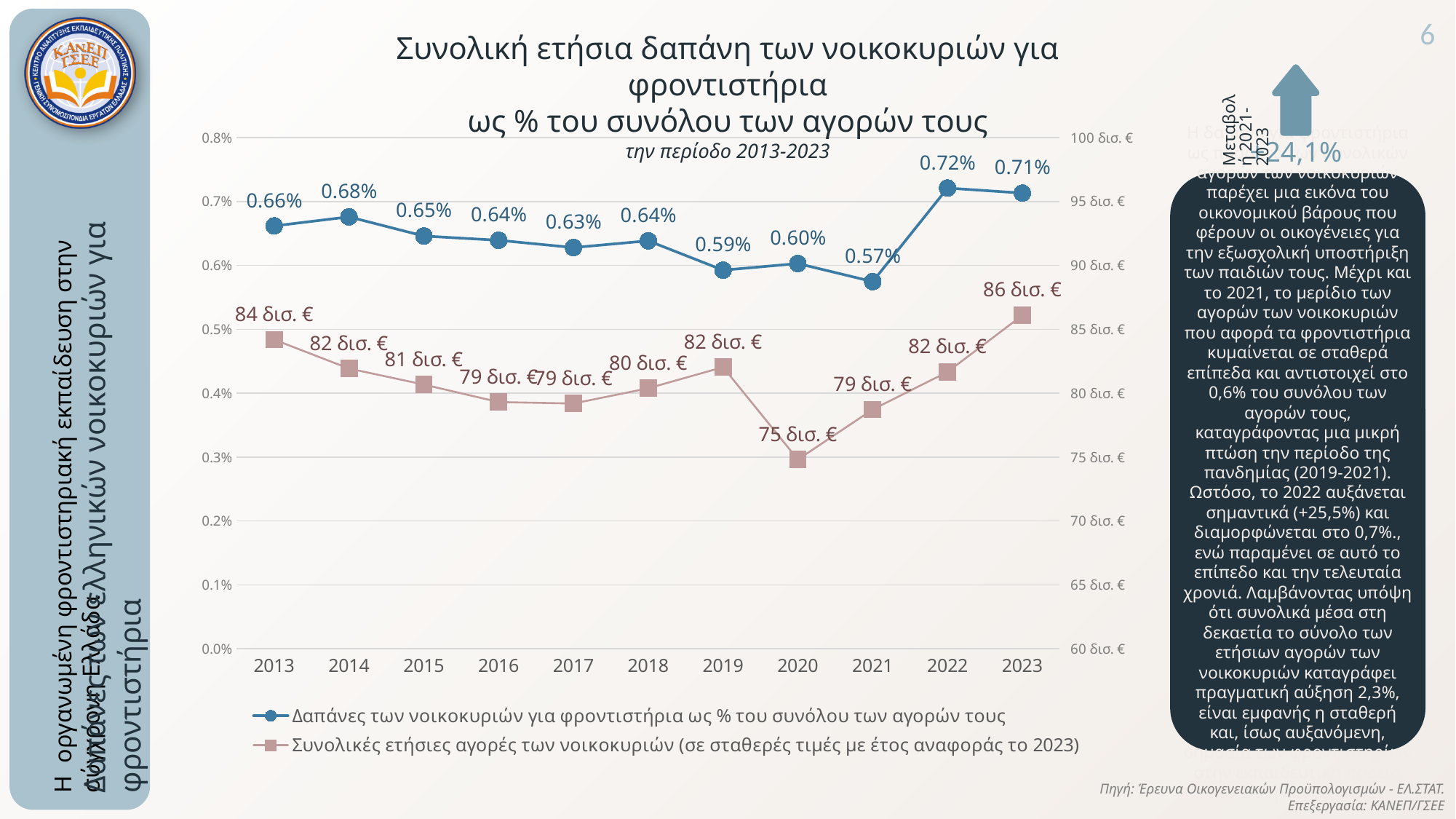
What type of chart is shown on the slide? line chart What is the value of total annual household purchases (Συνολικές ετήσιες αγορές) in 2020? 75 δισ. € What is the difference between the 2022 and 2021 values of spending on φροντιστήρια as % of total purchases? 0.15% What is the difference between total annual household purchases in 2023 and in 2013? 2 δισ. € How many years are plotted along the x axis? 11 Which year has the larger value of total annual household purchases, 2014 or 2021? 2014 In which year are total annual household purchases lowest? 2020 Does the spending on φροντιστήρια as % of total purchases rise or fall from 2013 to 2021? fall In which year is household spending on φροντιστήρια as % of total purchases highest? 2022 How many series does the legend list? 2 What period does the chart subtitle say the data covers? 2013-2023 What is the value of household spending on φροντιστήρια as % of total purchases in 2021? 0.57%